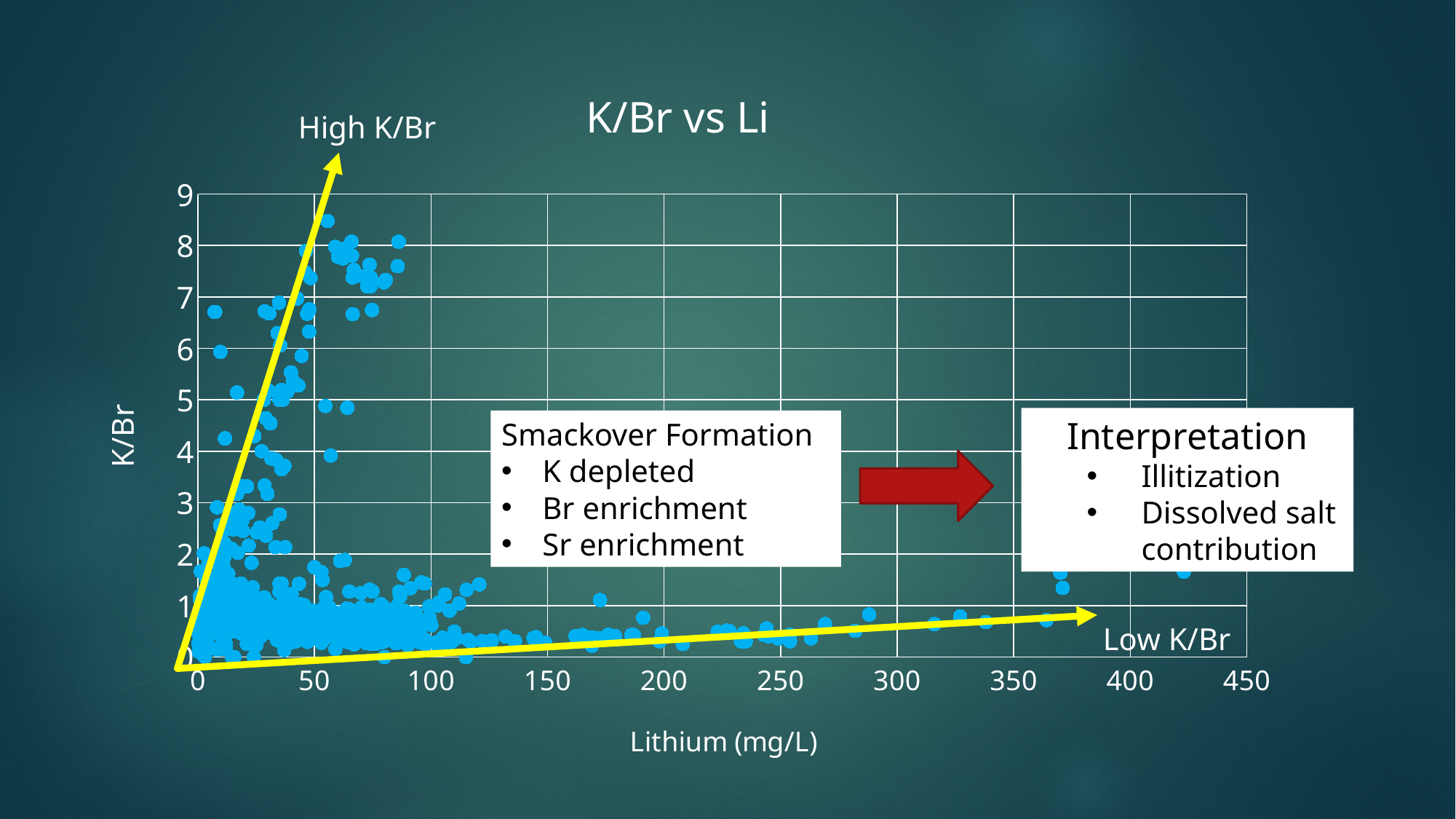
Is the largest lithium value plotted on the chart greater or less than 400? greater What is the title of the chart? K/Br vs Li What kind of chart is shown on the slide? scatter plot Is the highest K/Br value plotted on the chart greater or less than 8? greater What is the label of the x axis of the chart? Lithium (mg/L) Is the highest K/Br value plotted on the chart greater or less than 9? less